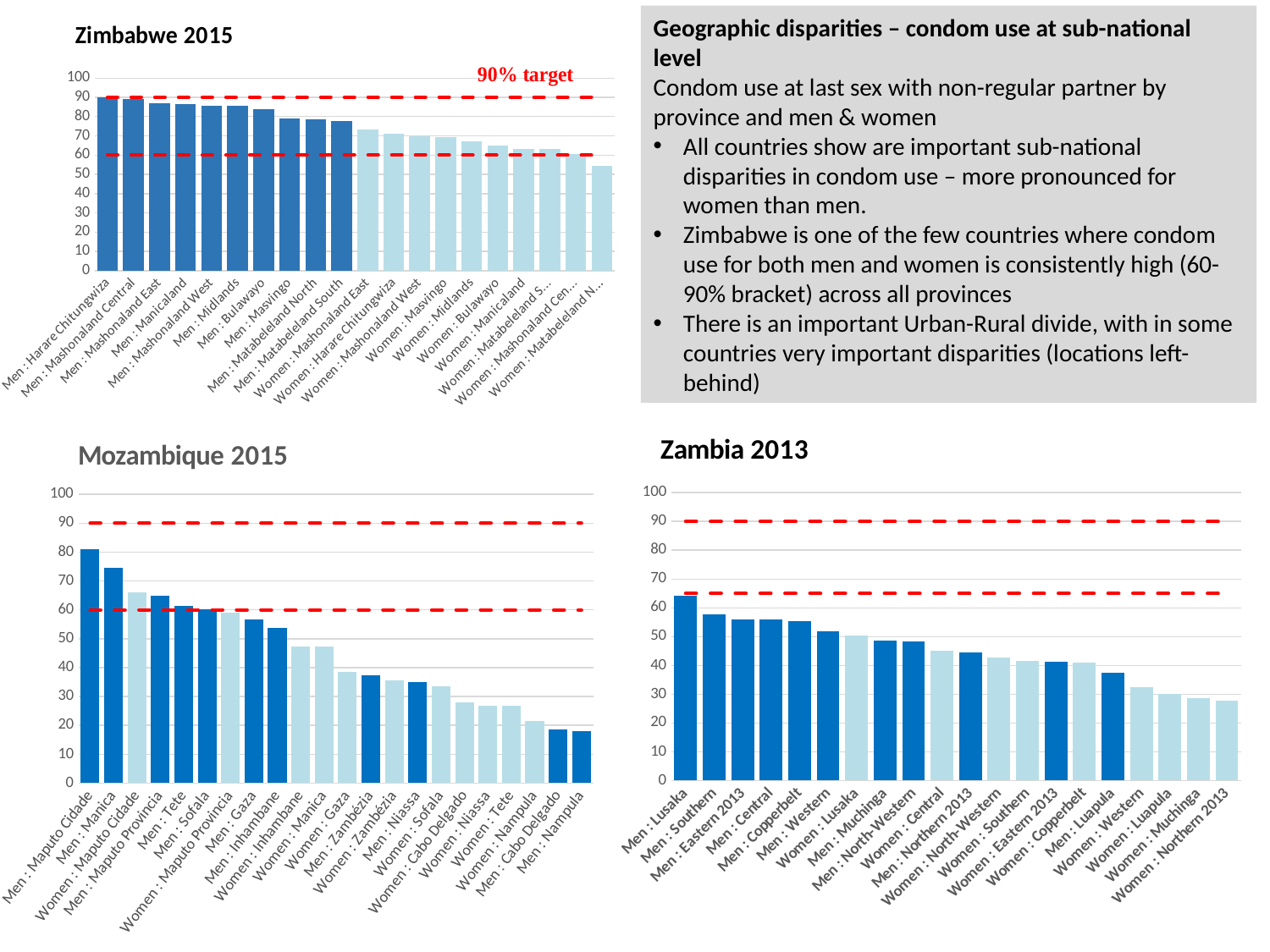
How many bars are plotted in the Mozambique 2015 chart? 22 In the Mozambique 2015 chart, which category has the highest value? Men : Maputo Cidade In the Zambia 2013 chart, which category has the highest value? Men : Lusaka What is the label on the upper red dashed line in the Zimbabwe 2015 chart? 90% target In the Zimbabwe 2015 chart, which category has the highest value? Men : Harare Chitungwiza In the Zambia 2013 chart, is the value for Men : Luapula greater or less than 40? less What kind of chart is the Zambia 2013 chart? bar chart How many bars are plotted in the Zimbabwe 2015 chart? 20 In the Zimbabwe 2015 chart, is the value for Women : Manicaland greater or less than 70? less In the Mozambique 2015 chart, which is larger, Men : Manica or Women : Maputo Cidade? Men : Manica In the Zimbabwe 2015 chart, is the value for Men : Harare Chitungwiza greater or less than 80? greater